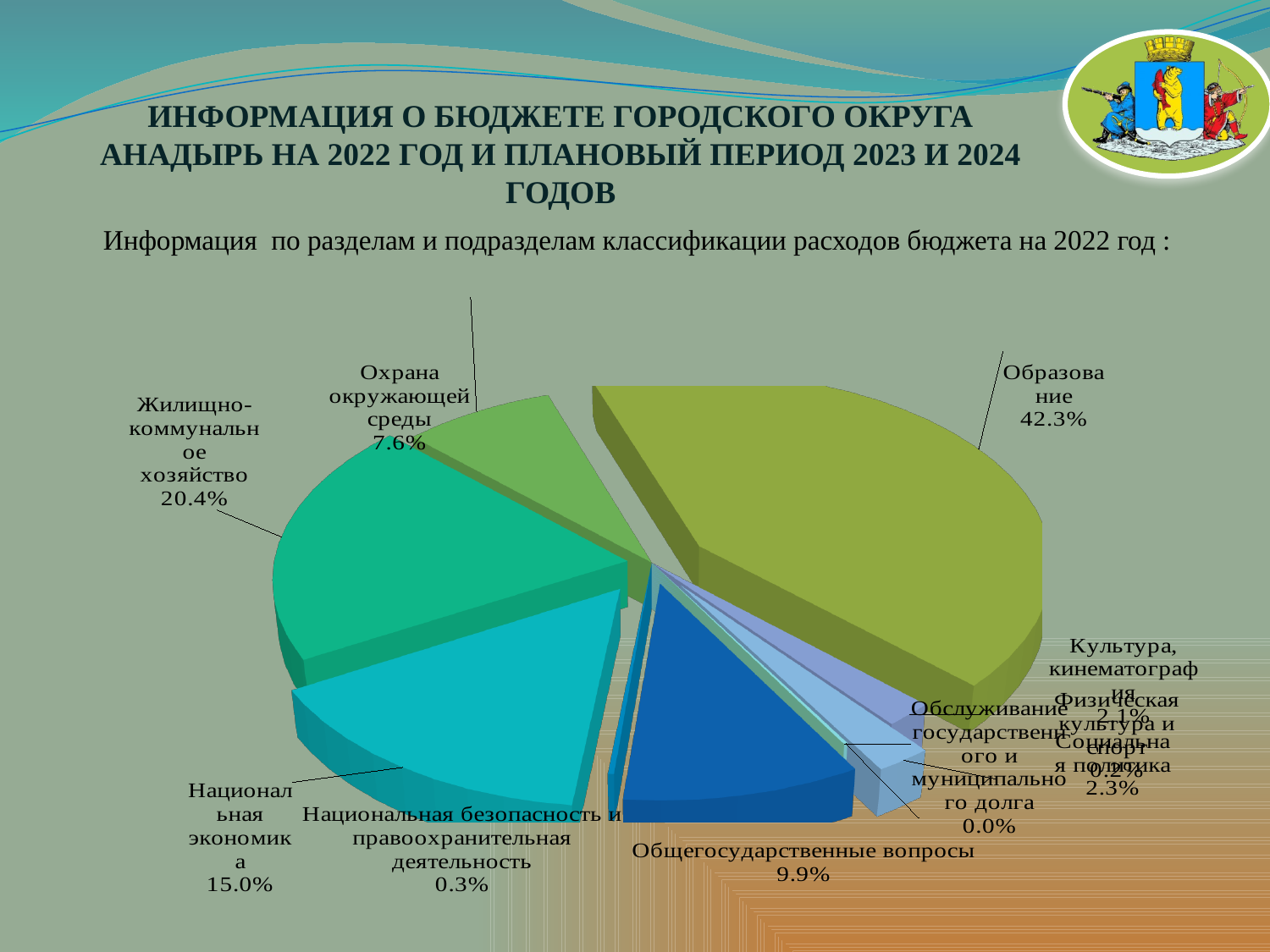
What share is shown for Охрана окружающей среды? 7.6% How many percentage points larger is the share of Образование than that of Жилищно-коммунальное хозяйство? 21.9 What share of the 2022 budget expenditure goes to Образование? 42.3% Which section has the smallest share, shown as 0.0%? Обслуживание государственного и муниципального долга What share is shown for Национальная безопасность и правоохранительная деятельность? 0.3% Which has the larger share: Национальная экономика or Общегосударственные вопросы? Национальная экономика What share is shown for Национальная экономика? 15.0% How many sections (slices) are shown in the pie chart? 10 Which section has the largest share of the budget expenditure? Образование What kind of chart is shown on the slide? Pie chart What share is shown for Общегосударственные вопросы? 9.9% What share is shown for Жилищно-коммунальное хозяйство? 20.4%